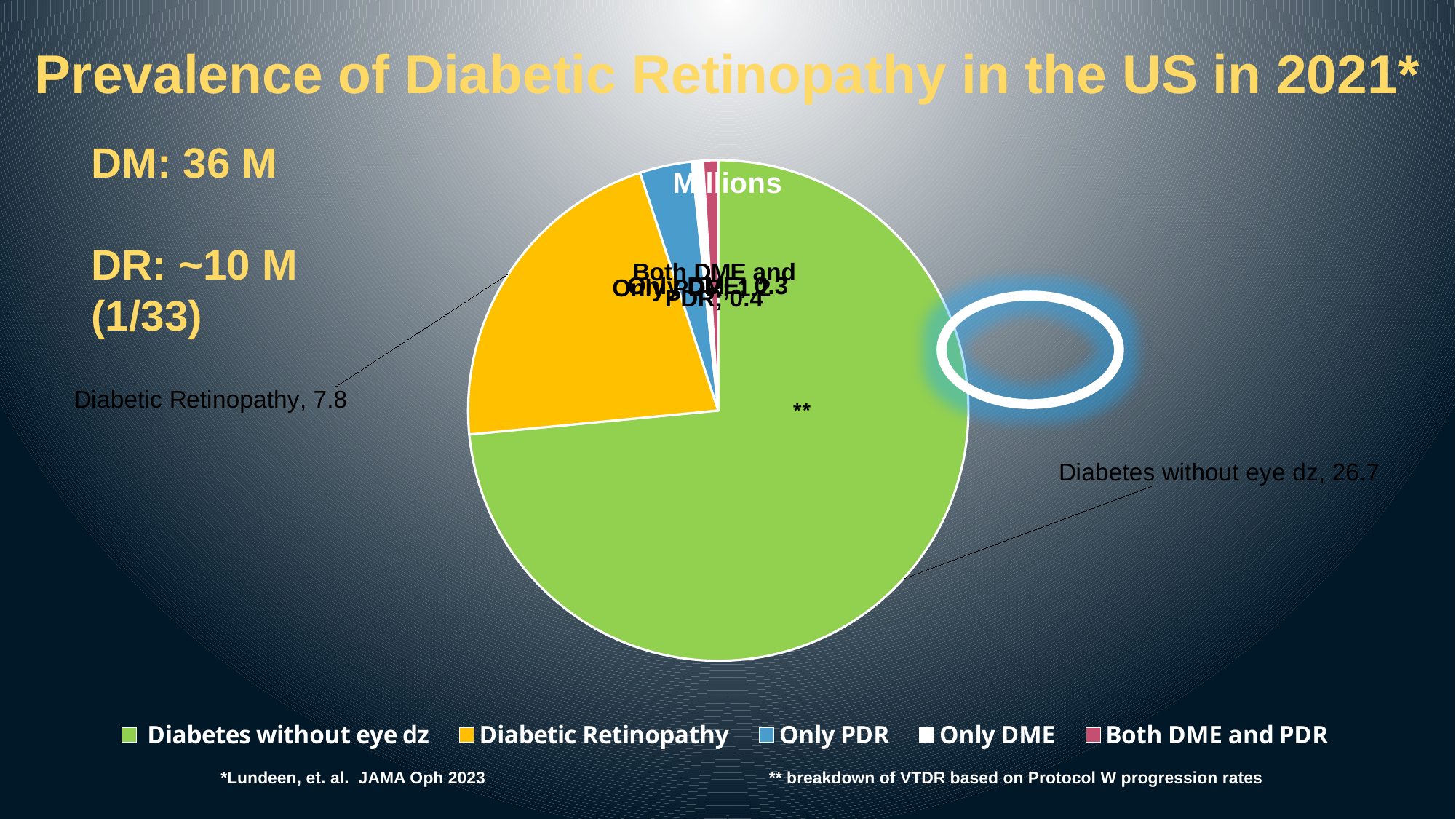
Which is larger, Diabetes without eye dz or Diabetic Retinopathy? Diabetes without eye dz What is the difference between the Diabetes without eye dz value and the Diabetic Retinopathy value? 18.9 How many slices does the pie chart have? 5 What colour is the Diabetic Retinopathy slice? Yellow Which category has the largest slice of the pie? Diabetes without eye dz How many entries does the legend list? 5 What value is shown for the Diabetes without eye dz slice? 26.7 What kind of chart is shown on the slide? Pie chart What is the title of the chart? Millions What value is shown for the Both DME and PDR slice? 0.4 What value is shown for the Diabetic Retinopathy slice? 7.8